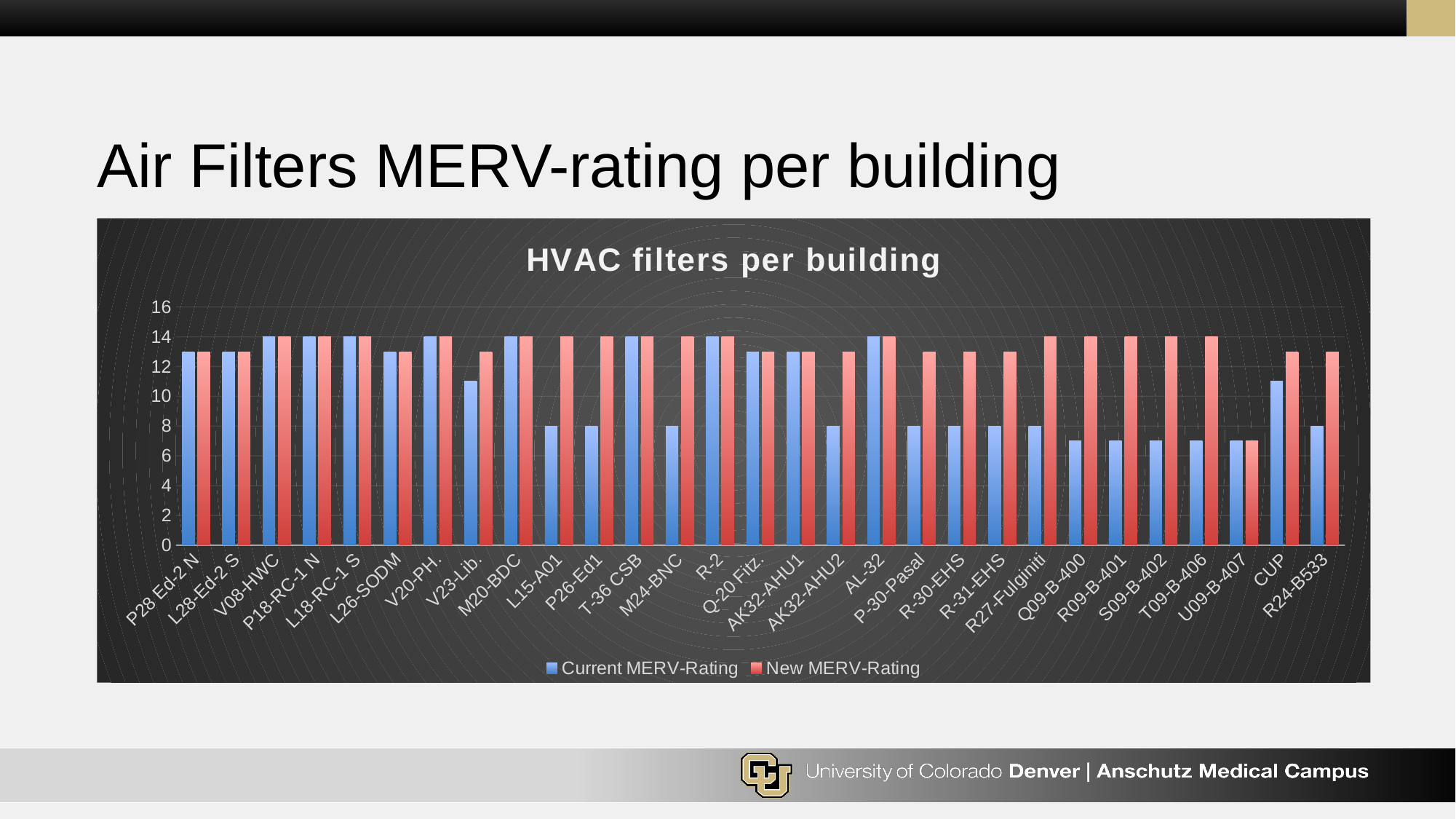
What is the New MERV-Rating for L15-A01? 14 What is the Current MERV-Rating for V08-HWC? 14 How many buildings are shown on the x axis? 29 What is the Current MERV-Rating for L15-A01? 8 What is the title of the chart? HVAC filters per building How many series does the legend list? 2 Is the New MERV-Rating for P28 Ed-2 N greater or less than 12? greater Is the Current MERV-Rating for CUP greater or less than 10? greater What kind of chart is shown on the slide? bar chart Is the Current MERV-Rating for U09-B-407 greater or less than 8? less For M24-BNC, which is larger: the Current MERV-Rating or the New MERV-Rating? New MERV-Rating What is the difference between the New MERV-Rating and the Current MERV-Rating for L15-A01? 6